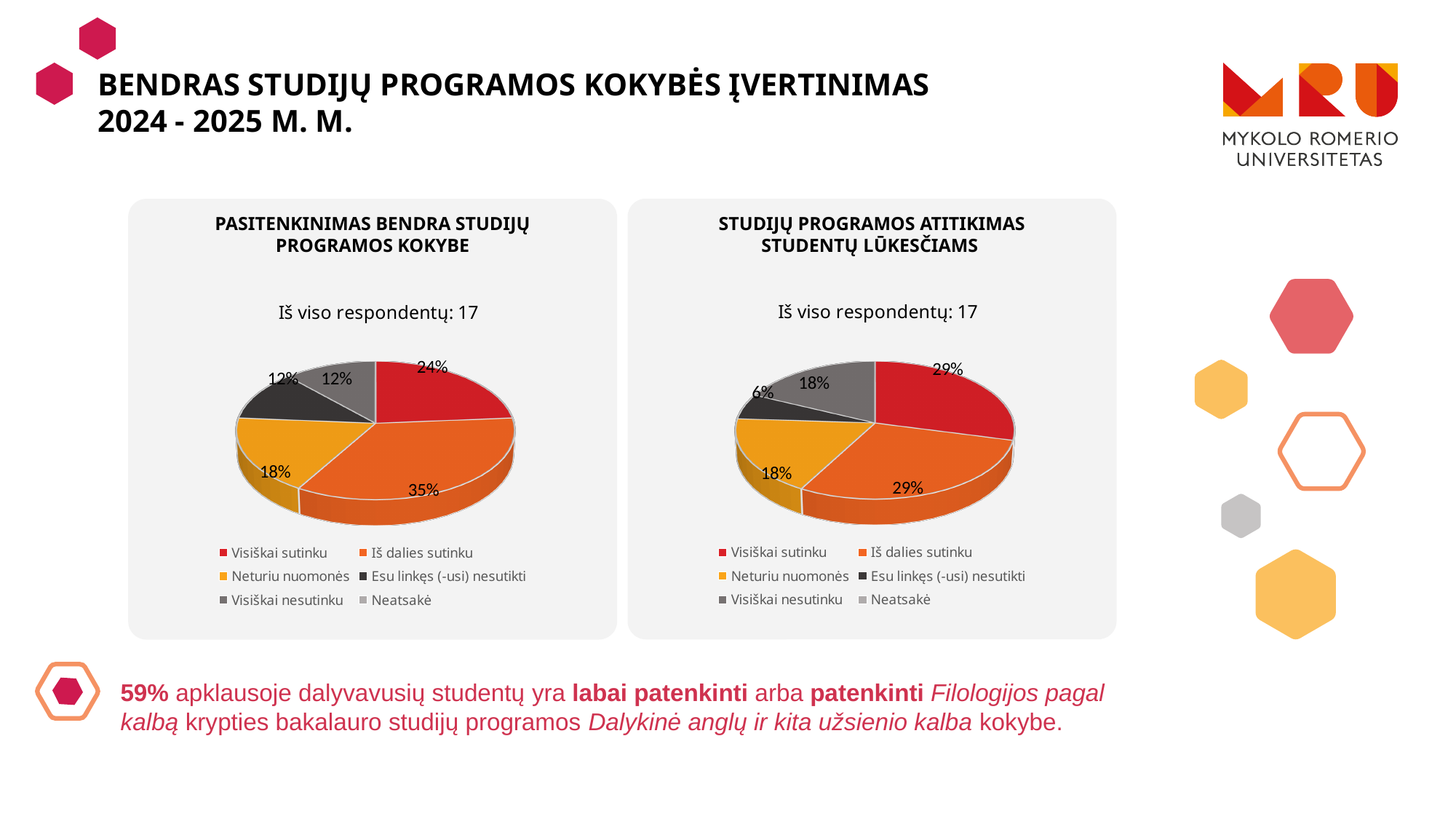
In the left chart (Pasitenkinimas bendra studijų programos kokybe), what is the difference in percentage points between Iš dalies sutinku and Visiškai sutinku? 11 How many entries does the legend of the left chart list? 6 In the left chart (Pasitenkinimas bendra studijų programos kokybe), what percentage is shown for Visiškai sutinku? 24% In the right chart (Studijų programos atitikimas studentų lūkesčiams), what percentage is shown for Visiškai nesutinku? 18% In the left chart (Pasitenkinimas bendra studijų programos kokybe), what percentage is shown for Neturiu nuomonės? 18% What type of chart is used on this slide? Pie chart In the left chart (Pasitenkinimas bendra studijų programos kokybe), what percentage is shown for Iš dalies sutinku? 35% In the right chart (Studijų programos atitikimas studentų lūkesčiams), which is larger: Visiškai sutinku or Neturiu nuomonės? Visiškai sutinku In the right chart (Studijų programos atitikimas studentų lūkesčiams), which category has the smallest slice? Esu linkęs (-usi) nesutikti How many respondents are reported for the right chart (Studijų programos atitikimas studentų lūkesčiams)? 17 In the right chart (Studijų programos atitikimas studentų lūkesčiams), what percentage is shown for Esu linkęs (-usi) nesutikti? 6% In the left chart (Pasitenkinimas bendra studijų programos kokybe), which category has the largest slice? Iš dalies sutinku